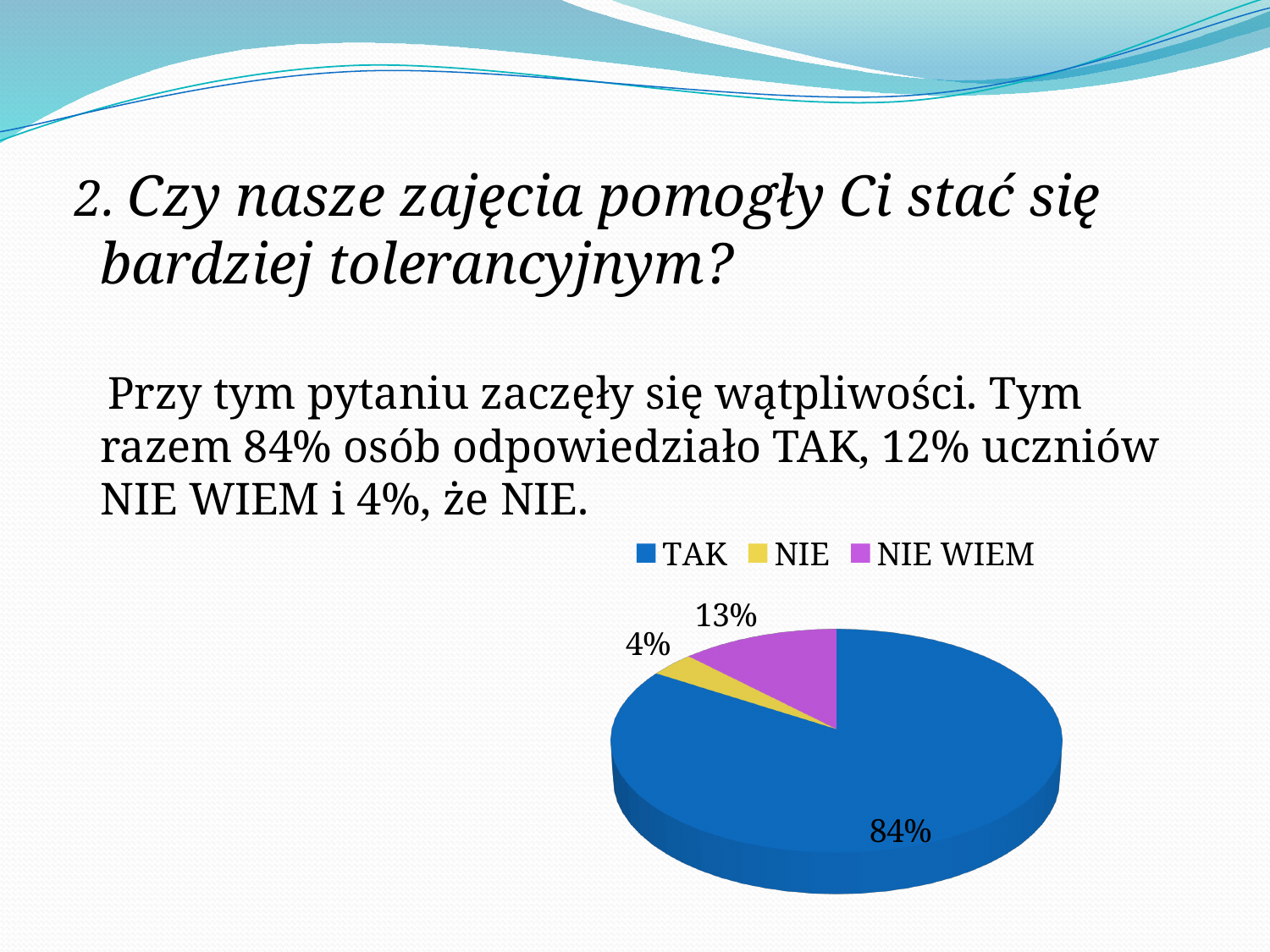
Which category has the largest slice in the pie chart? TAK What percentage is shown for the NIE WIEM slice of the pie chart? 13% What colour is the TAK slice in the pie chart? blue What is the difference in percentage points between the TAK slice and the NIE WIEM slice? 71 What colour is the NIE WIEM slice in the pie chart? purple What percentage is shown for the TAK slice of the pie chart? 84% Which category has the smallest slice in the pie chart? NIE How many slices does the pie chart have? 3 What kind of chart is shown on the slide? pie chart How many entries does the legend of the pie chart list? 3 Which slice is larger in the pie chart, NIE or NIE WIEM? NIE WIEM What percentage is shown for the NIE slice of the pie chart? 4%